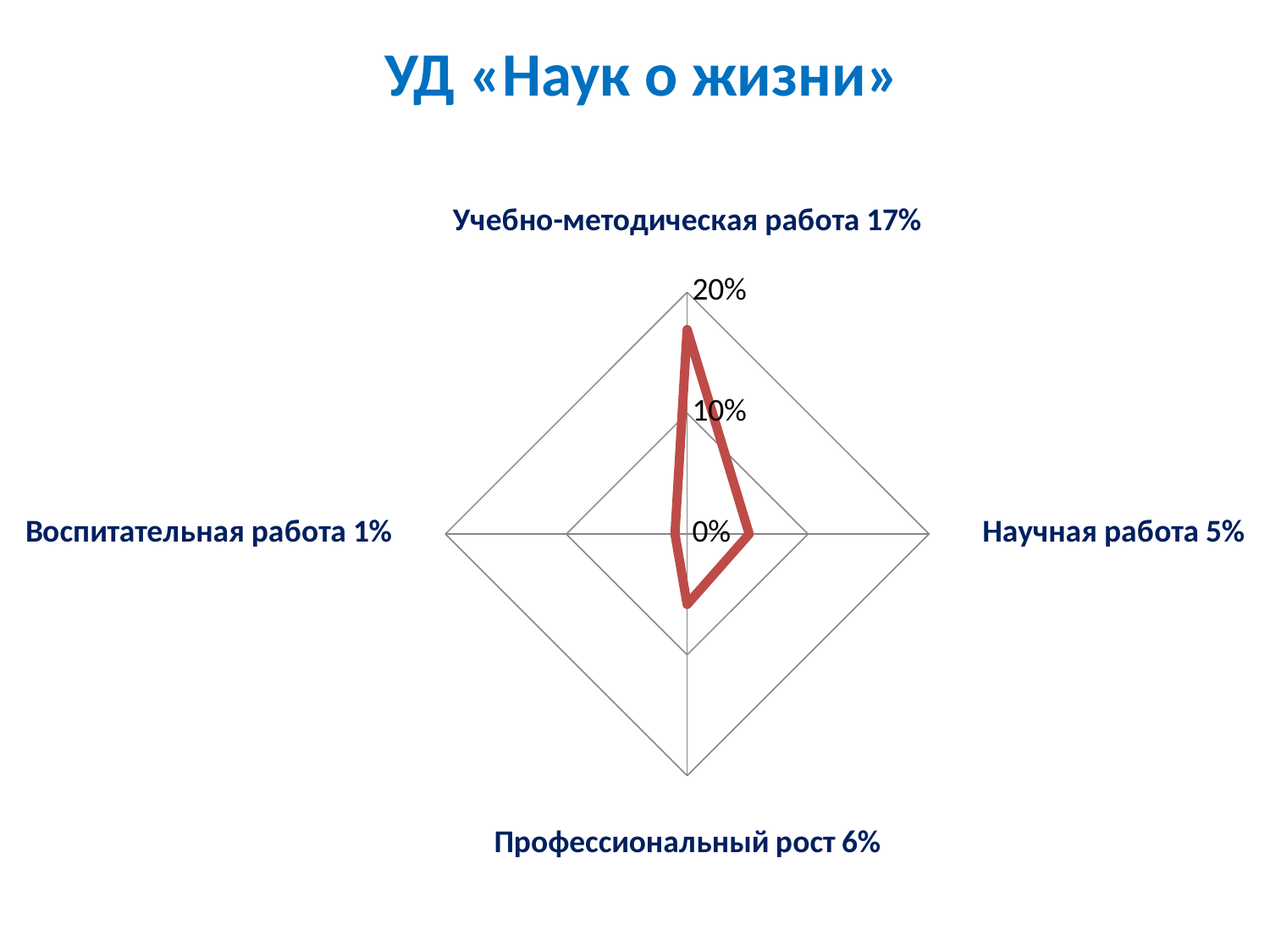
What kind of chart is shown on the slide? Radar chart What is the value for Воспитательная работа? 1% Which is larger, the value for Профессиональный рост or the value for Научная работа? Профессиональный рост Which category has the highest value? Учебно-методическая работа What is the value for Профессиональный рост? 6% What is the title of the slide? УД «Наук о жизни» What is the value for Учебно-методическая работа? 17% What is the value for Научная работа? 5% Which category has the lowest value? Воспитательная работа How many categories (axes) does the radar chart have? 4 What is the difference between the values for Учебно-методическая работа and Научная работа? 12% Is the value for Учебно-методическая работа greater or less than 10%? greater